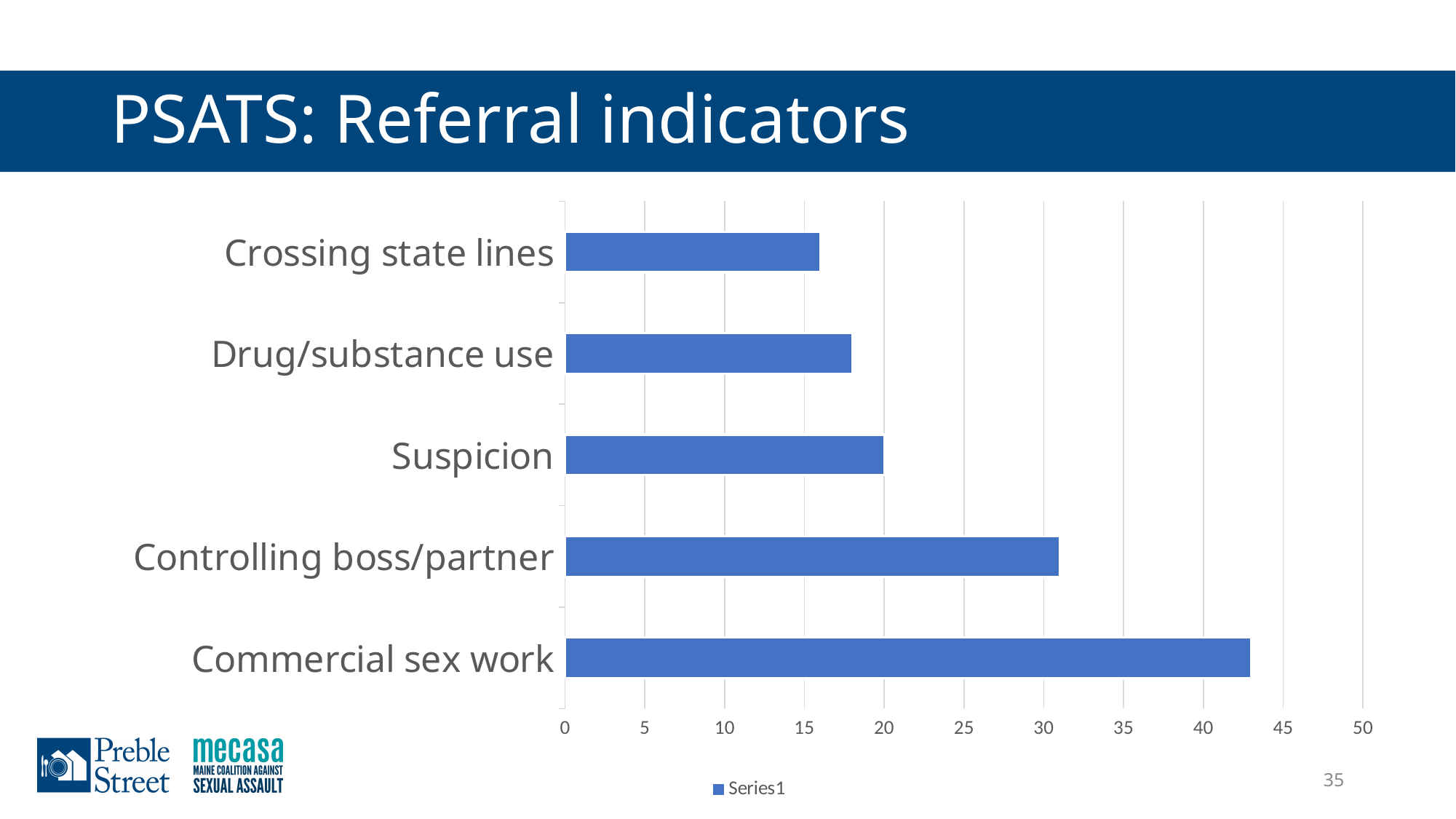
Is the value for Crossing state lines greater or less than 20? less How many categories are plotted in the chart? 5 What is the value for Suspicion? 20 What is the title of the slide containing the chart? PSATS: Referral indicators Is the value for Controlling boss/partner greater or less than 30? greater Is the value for Commercial sex work greater or less than 40? greater Which category has the highest value? Commercial sex work Which category has the lowest value? Crossing state lines How many series does the legend list? 1 What kind of chart is shown on the slide? bar chart Which is larger, the value for Controlling boss/partner or the value for Suspicion? Controlling boss/partner